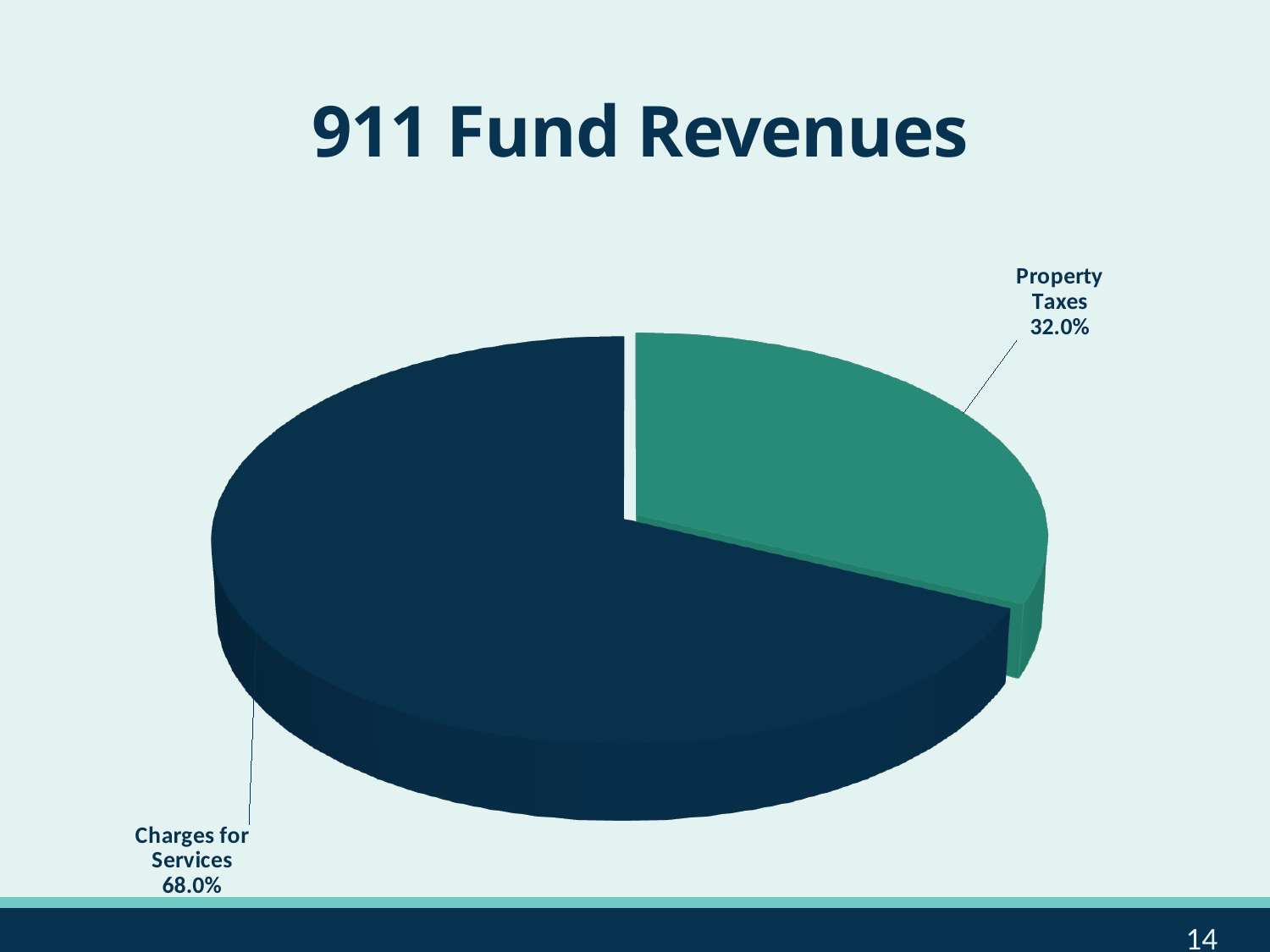
Which revenue source is the largest slice of the pie? Charges for Services What colour is the Property Taxes slice? Green What is the title of the chart? 911 Fund Revenues Which is larger, Charges for Services or Property Taxes? Charges for Services What kind of chart is shown on the slide? Pie chart What is the difference in percentage points between Charges for Services and Property Taxes? 36.0 percentage points How many slices does the pie chart have? 2 What share of 911 Fund Revenues comes from Property Taxes? 32.0% Which revenue source is the smallest slice of the pie? Property Taxes What share of 911 Fund Revenues comes from Charges for Services? 68.0%